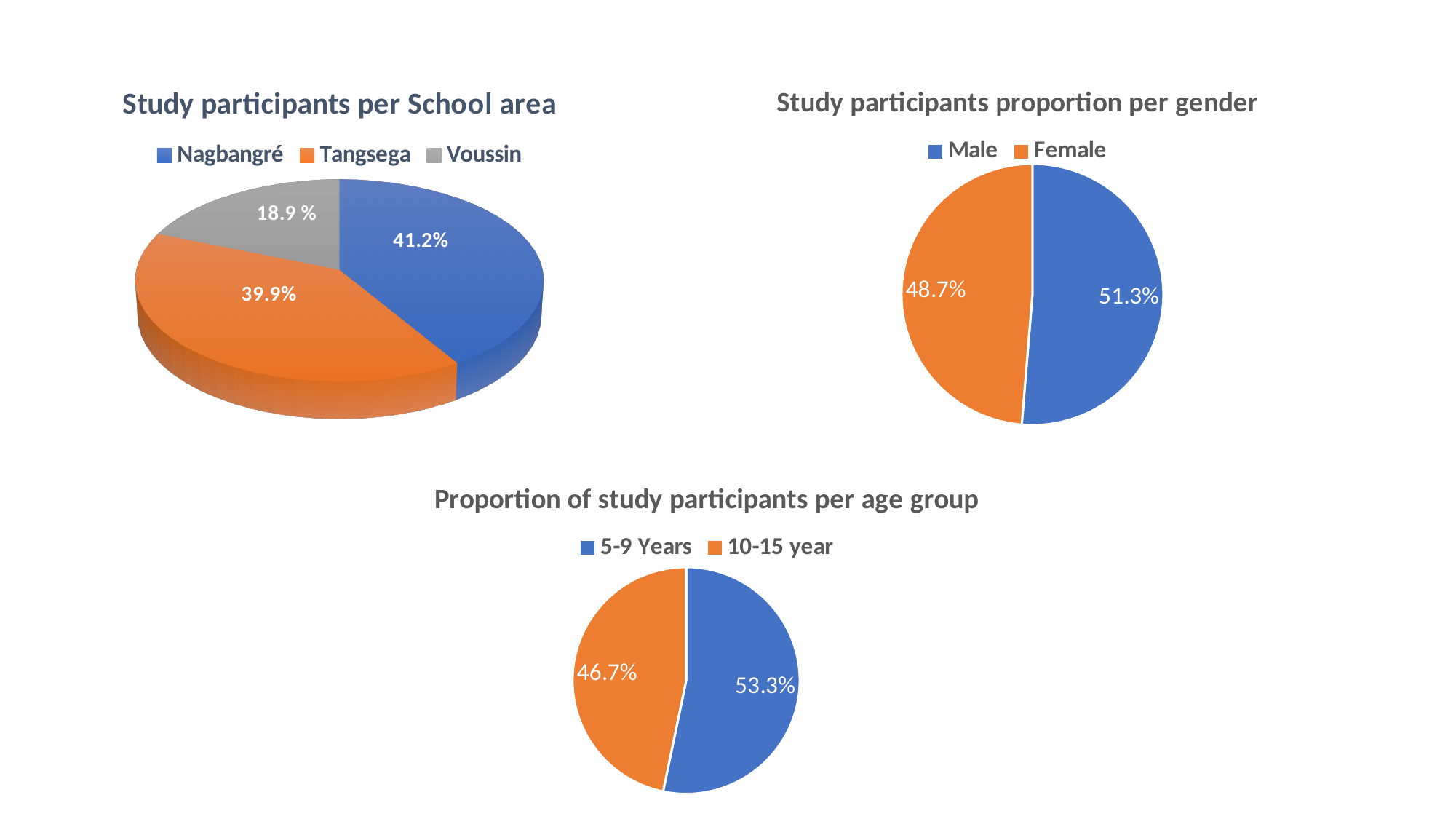
In the 'Proportion of study participants per age group' chart, what is the share of the 5-9 Years group? 53.3% In the 'Study participants proportion per gender' chart, what is the share of Male participants? 51.3% In the 'Proportion of study participants per age group' chart, what is the share of the 10-15 year group? 46.7% In the 'Study participants per School area' chart, how many school areas are shown? 3 In the 'Study participants per School area' chart, what share of participants is from Nagbangré? 41.2% In the 'Study participants per School area' chart, what is the difference between the Nagbangré and Voussin shares? 22.3 percentage points In the 'Study participants per School area' chart, which school area has the smallest share? Voussin In the 'Study participants per School area' chart, which colour represents Tangsega? Orange What kind of chart is 'Proportion of study participants per age group'? Pie chart In the 'Study participants per School area' chart, what share of participants is from Voussin? 18.9 % In the 'Study participants proportion per gender' chart, what is the difference between the Male and Female shares? 2.6 percentage points In the 'Study participants proportion per gender' chart, what is the share of Female participants? 48.7%